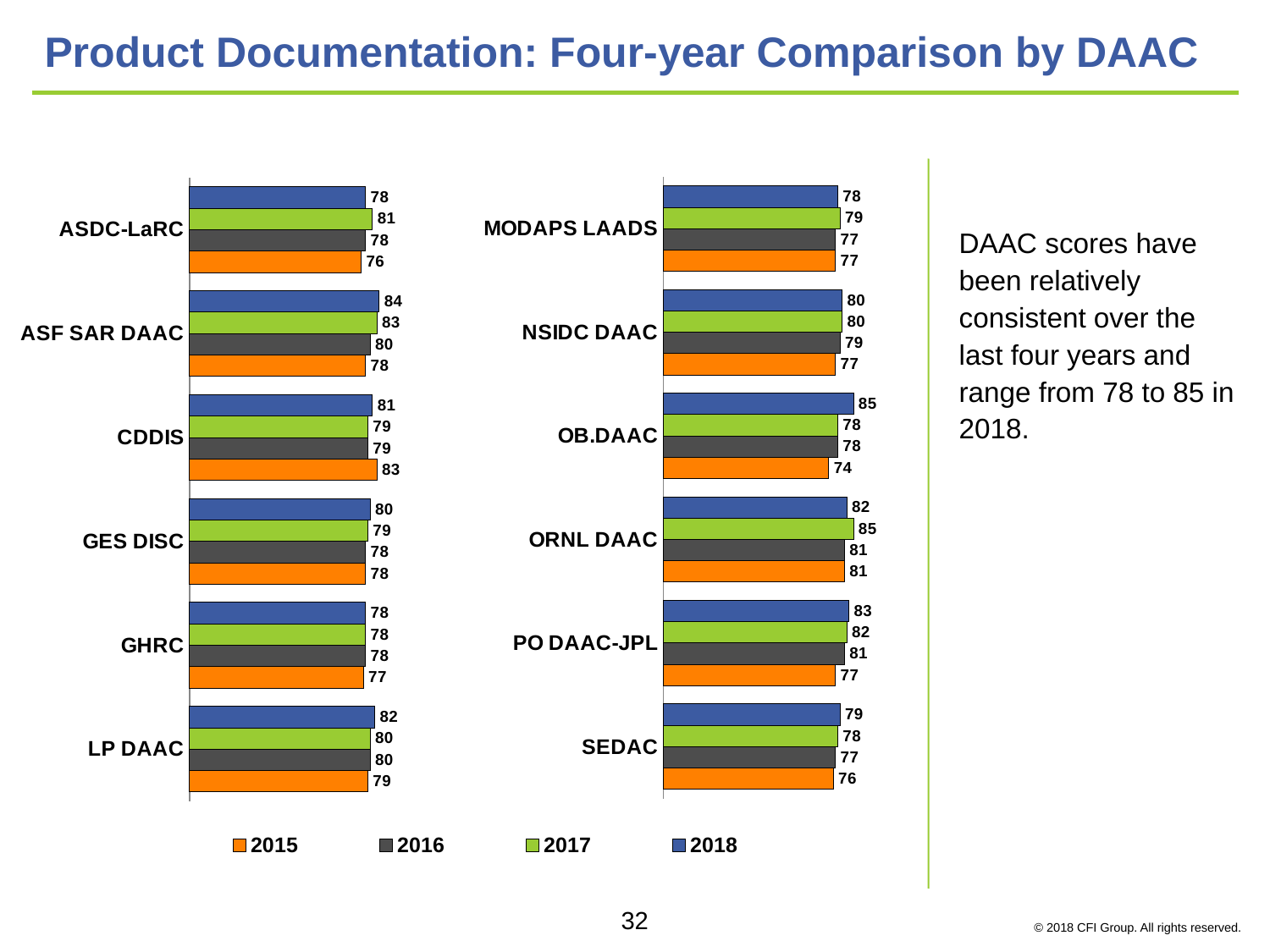
In the right chart, which DAAC has the highest 2018 value? OB.DAAC In the right chart, which is larger for ORNL DAAC: the 2017 value or the 2018 value? 2017 In the left chart, what is the 2018 value for ASF SAR DAAC? 84 In the left chart, what is the difference between the 2015 and 2018 values for CDDIS? 2 How many DAACs are shown in the left chart? 6 In the right chart, what is the 2015 value for OB.DAAC? 74 In the left chart, which DAAC has the lowest 2015 value? ASDC-LaRC Which colour represents 2015 in the legend? Orange In the right chart, what is the difference between the 2018 and 2015 values for OB.DAAC? 11 How many series does the legend list? 4 What kind of chart is used on this slide? Bar chart In the left chart, what is the 2017 value for ASDC-LaRC? 81